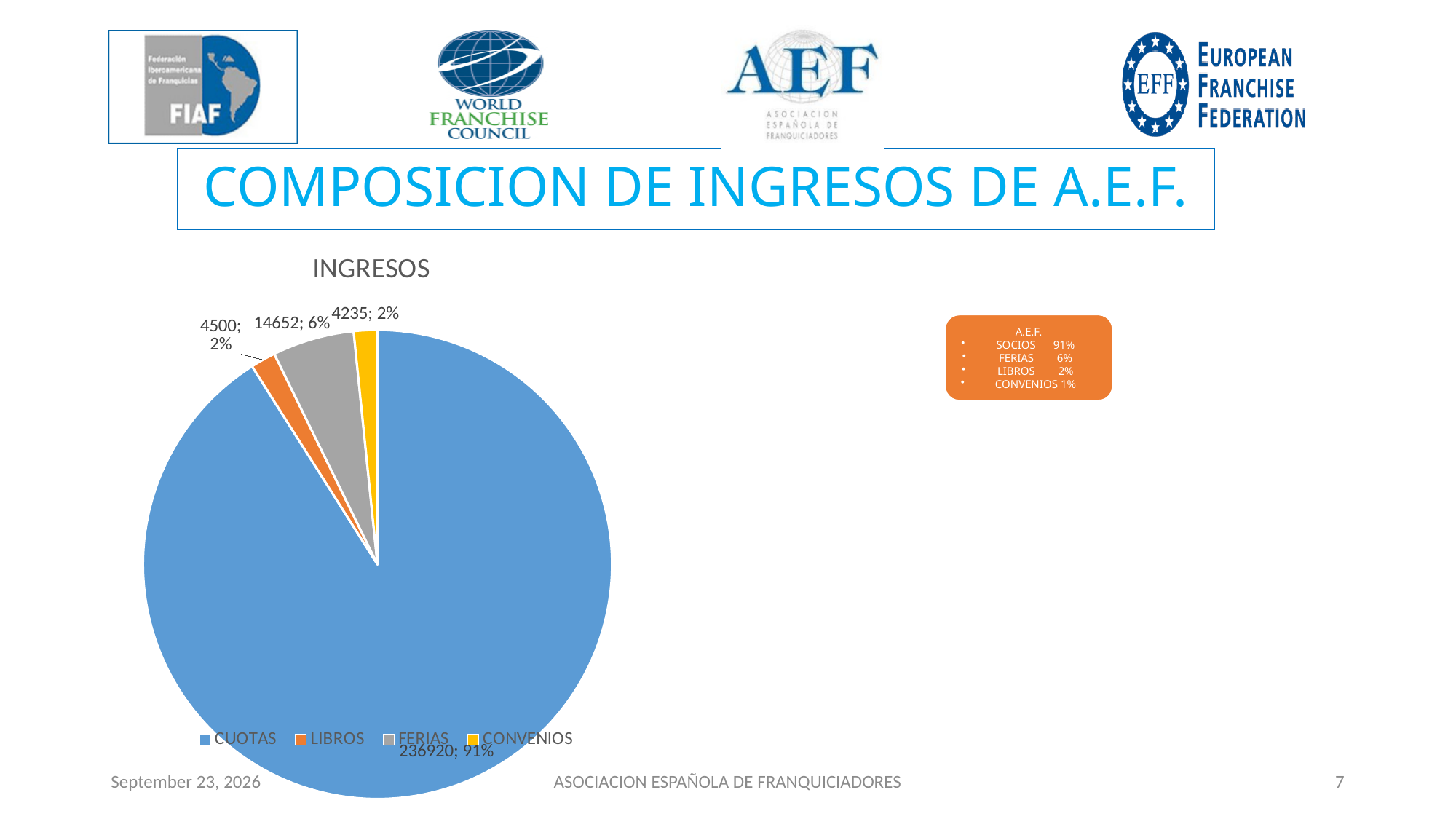
What is the title of the chart? INGRESOS Which category has the largest slice of the pie? CUOTAS What is the value shown for CUOTAS? 236920 What is the value shown for LIBROS? 4500 How many entries does the chart legend list? 4 What share of the pie does CUOTAS represent? 91% What type of chart is shown on the slide? pie chart What share of the pie does FERIAS represent? 6% What is the difference between the values for FERIAS and LIBROS? 10152 What is the value shown for FERIAS? 14652 How many slices does the pie chart have? 4 What is the value shown for CONVENIOS? 4235